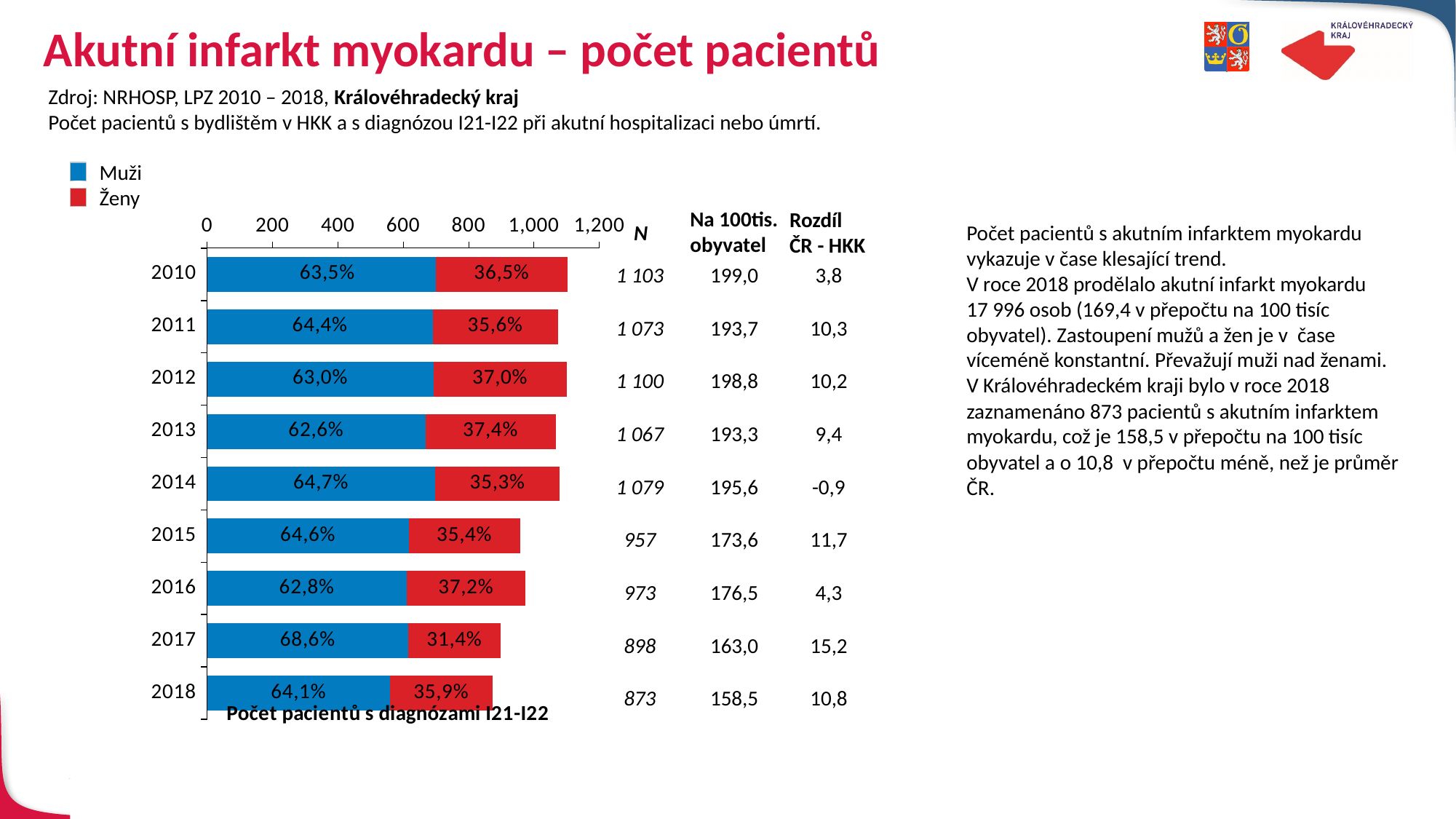
What is the Muži share shown for 2017? 68,6% How many years are shown on the chart's vertical axis? 9 What kind of chart is shown on the slide? Bar chart Do the total bar lengths generally rise or fall from 2010 to 2018? fall Is the total bar length for 2018 greater or less than 1,000? less Is the total bar length for 2010 greater or less than 1,000? greater What is the Ženy share shown for 2010? 36,5% Which year has the highest Muži percentage? 2017 Which year has the lowest Muži percentage? 2013 How many series does the legend of the chart list? 2 Which year has the larger Ženy share, 2012 or 2014? 2012 By how many percentage points does the Muži share exceed the Ženy share in 2017? 37,2 percentage points